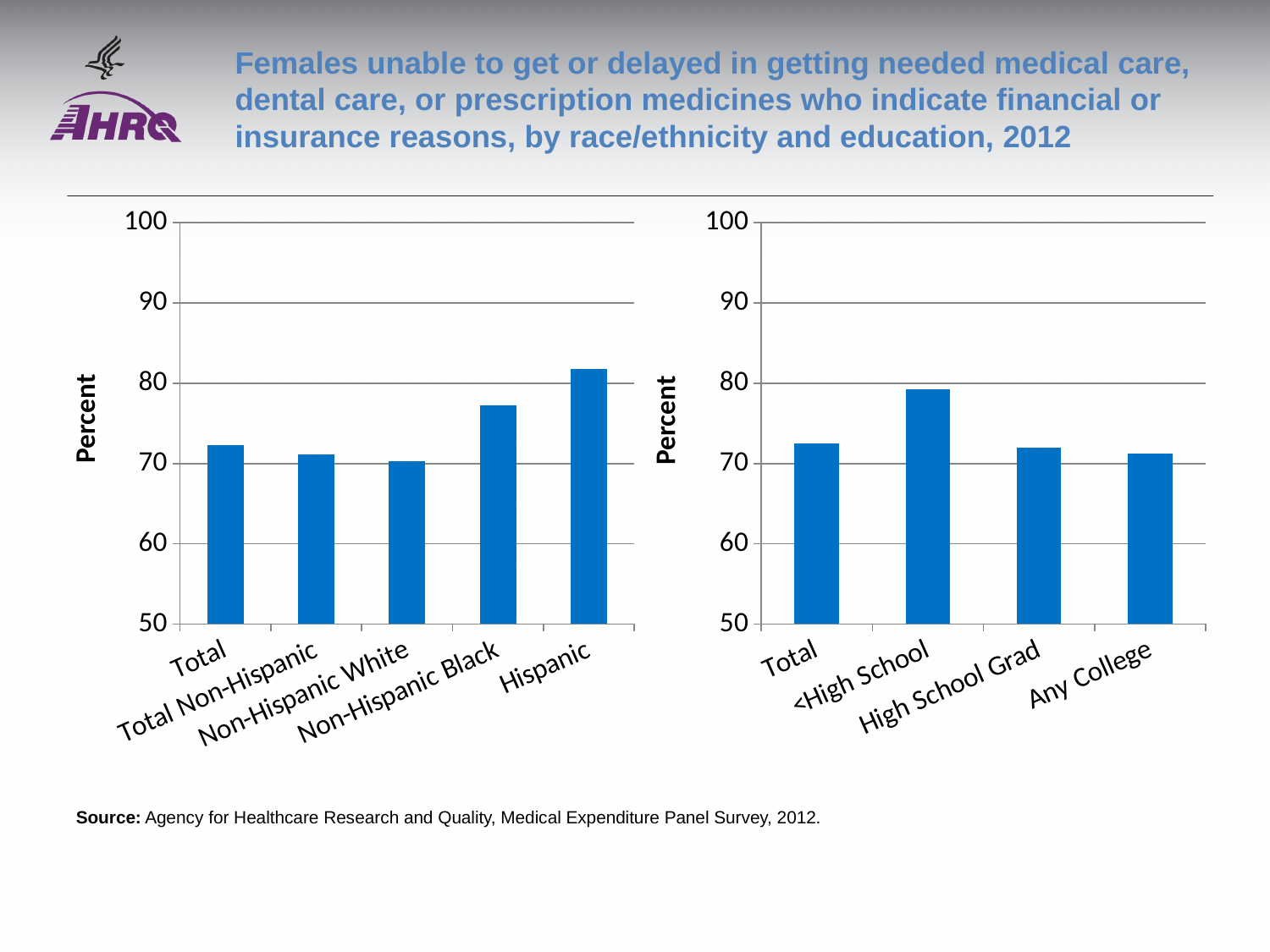
In the left chart (by race/ethnicity), how many categories are shown on the x axis? 5 In the left chart (by race/ethnicity), is the value for Non-Hispanic Black greater or less than 80? less What kind of chart is the left chart (by race/ethnicity)? Bar chart In the right chart (by education), which category has the highest value? <High School In the left chart (by race/ethnicity), which category has the highest value? Hispanic In the right chart (by education), is the value for Any College greater or less than 70? greater In the right chart (by education), how many categories are shown on the x axis? 4 In the left chart (by race/ethnicity), which category has the lowest value? Non-Hispanic White In the right chart (by education), which is larger, the value for <High School or the value for High School Grad? <High School In the right chart (by education), is the value for <High School greater or less than 80? less